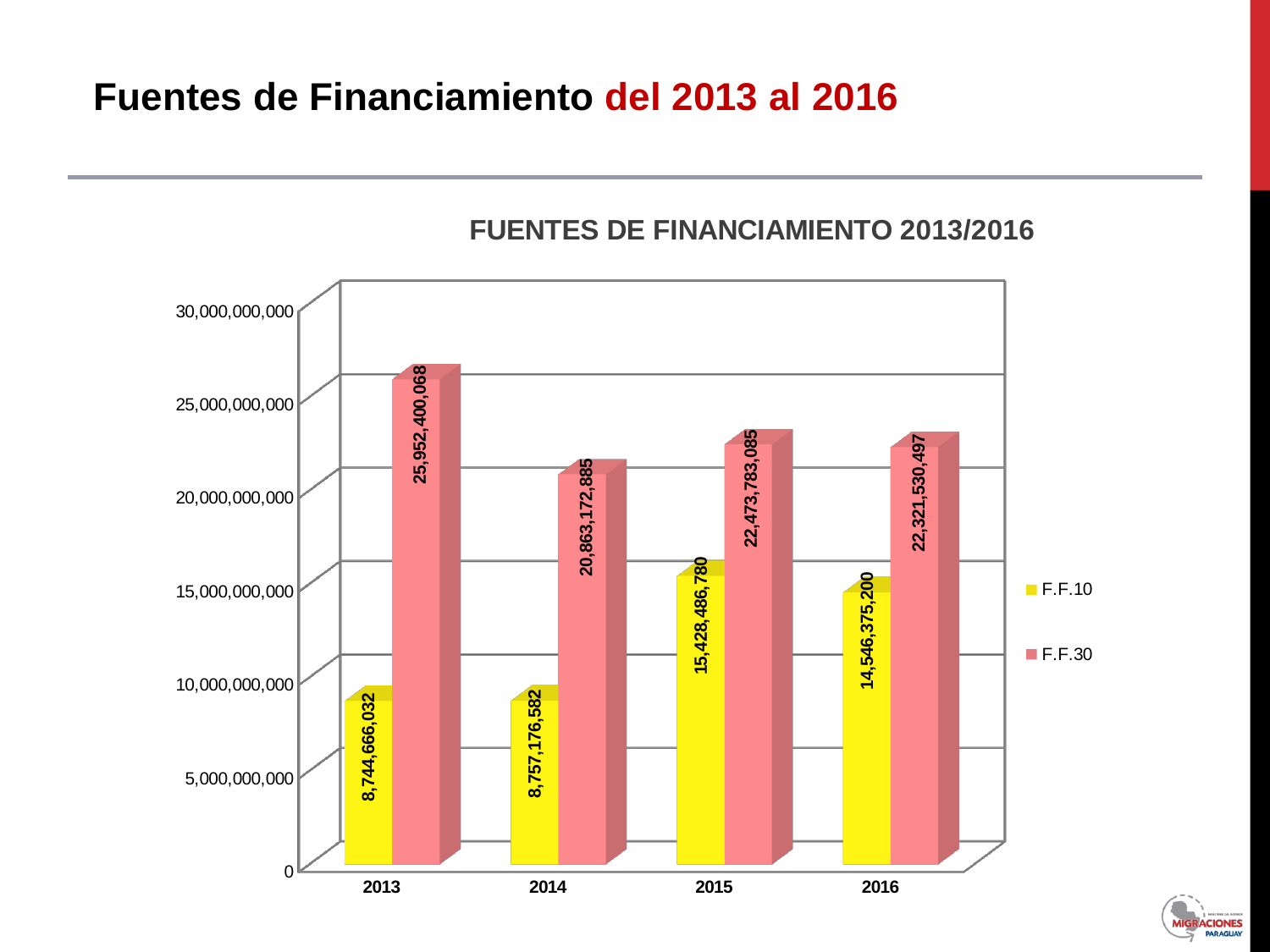
How many years are shown on the x axis? 4 What is the value for F.F.30 in 2013? 25,952,400,068 What is the difference between F.F.30 and F.F.10 in 2013? 17,207,734,036 In which year is the F.F.30 value lowest? 2014 Which is larger, F.F.10 in 2015 or F.F.10 in 2016? F.F.10 in 2015 What is the value for F.F.10 in 2014? 8,757,176,582 How many series does the legend list? 2 In which year is the F.F.30 value highest? 2013 In which year is the F.F.10 value highest? 2015 What is the value for F.F.10 in 2015? 15,428,486,780 What is the value for F.F.30 in 2016? 22,321,530,497 What kind of chart is shown on the slide? Bar chart